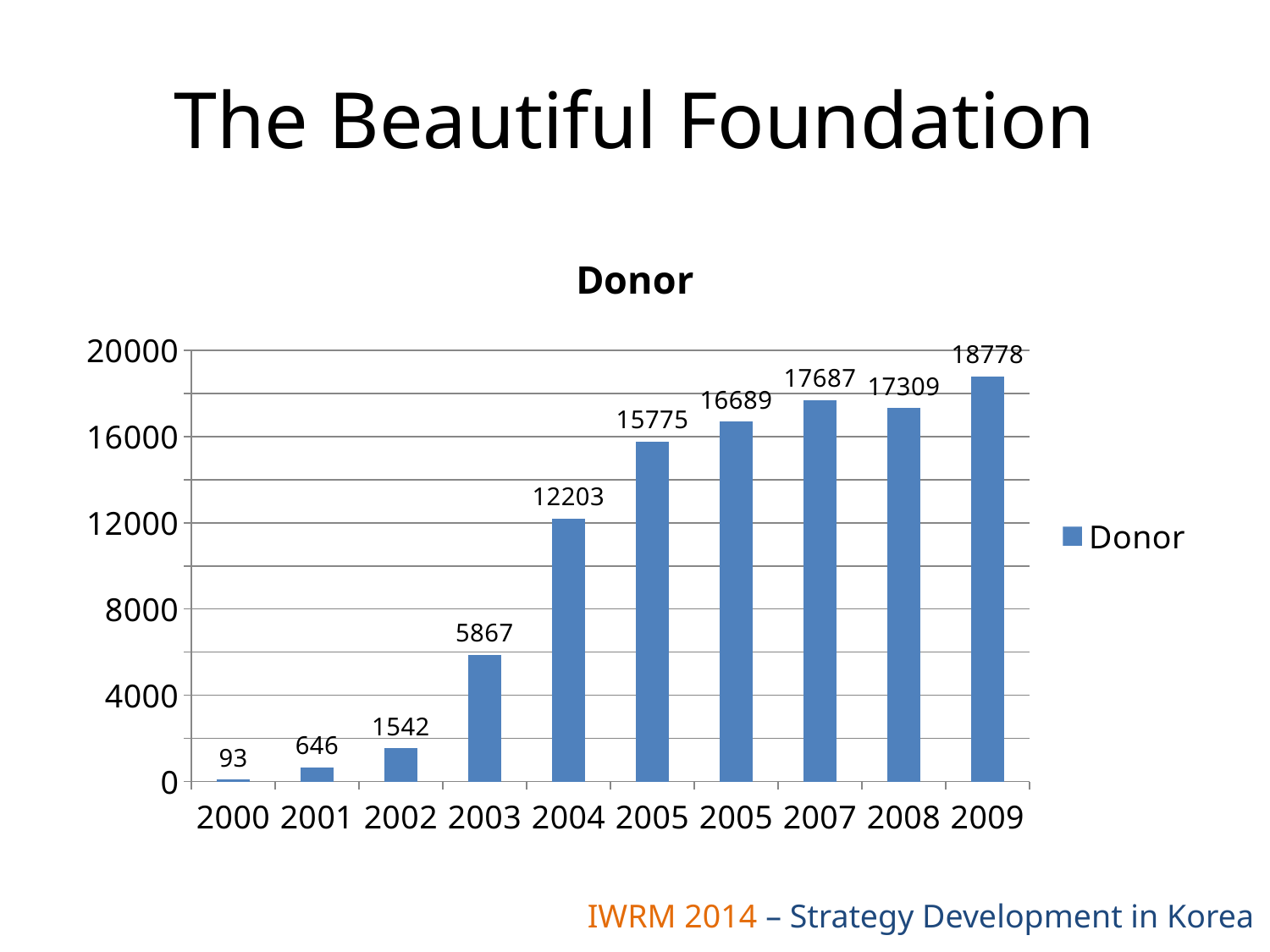
What is the title of the chart? Donor Which year has the highest Donor value? 2009 What kind of chart is shown on the slide? Bar chart What is the Donor value for 2003? 5867 Which year has the larger Donor value, 2007 or 2008? 2007 What is the Donor value for 2008? 17309 What is the Donor value for 2009? 18778 How many bars are shown in the chart? 10 What is the difference between the Donor values for 2009 and 2008? 1469 How many series does the legend list? 1 What is the Donor value for 2000? 93 Which year has the lowest Donor value? 2000